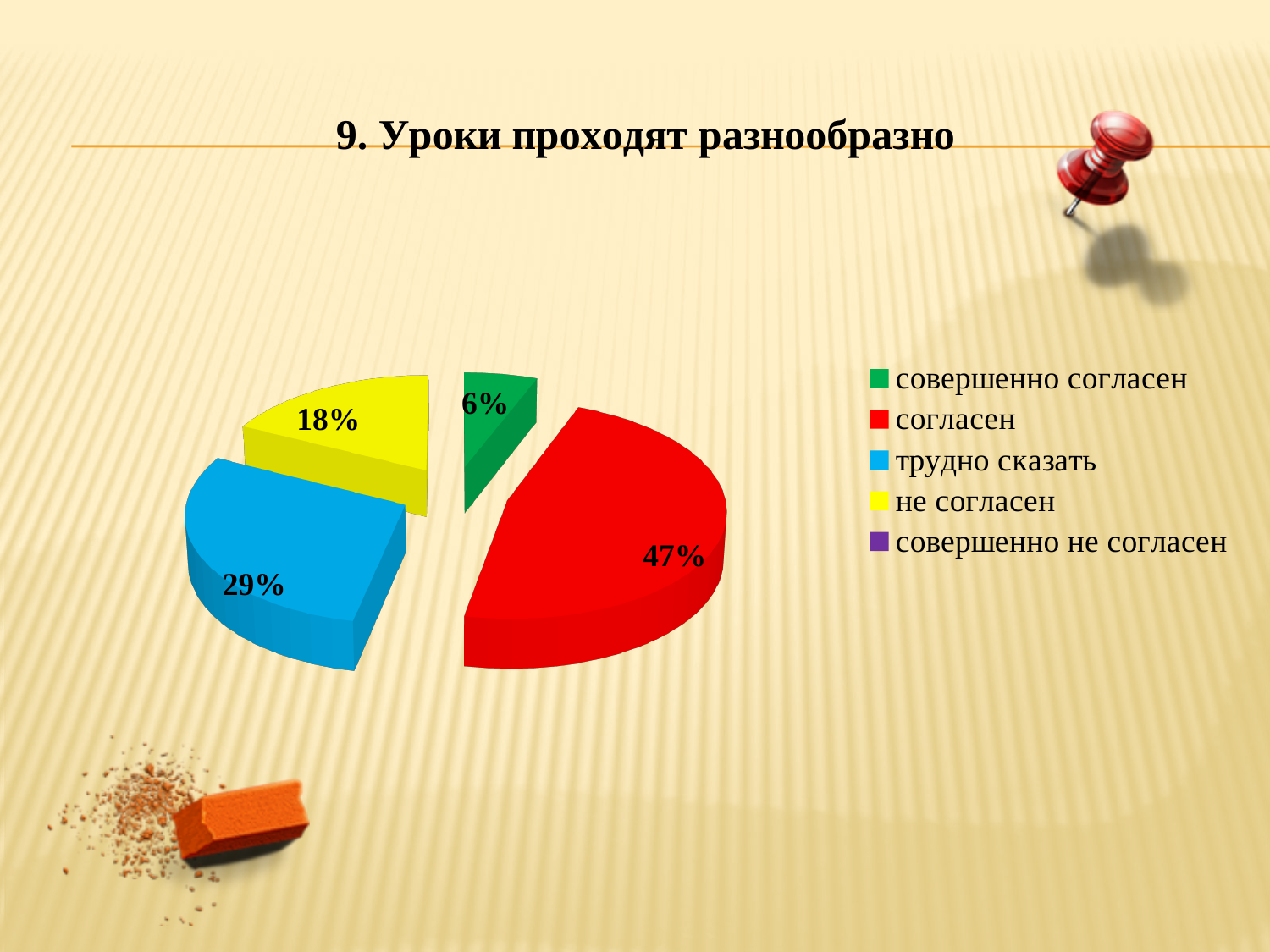
What colour is the slice for "не согласен"? yellow What type of chart is shown on the slide? pie chart What is the title of the chart on the slide? 9. Уроки проходят разнообразно What is the difference in percentage points between "согласен" and "трудно сказать"? 18 Which category has the largest share of the pie? согласен What percentage of the pie corresponds to "совершенно согласен"? 6% What percentage of the pie corresponds to "согласен"? 47% What percentage of the pie corresponds to "не согласен"? 18% What percentage of the pie corresponds to "трудно сказать"? 29% How many entries does the legend list? 5 Which is larger: the share for "не согласен" or the share for "трудно сказать"? трудно сказать Which labelled slice has the smallest share of the pie? совершенно согласен